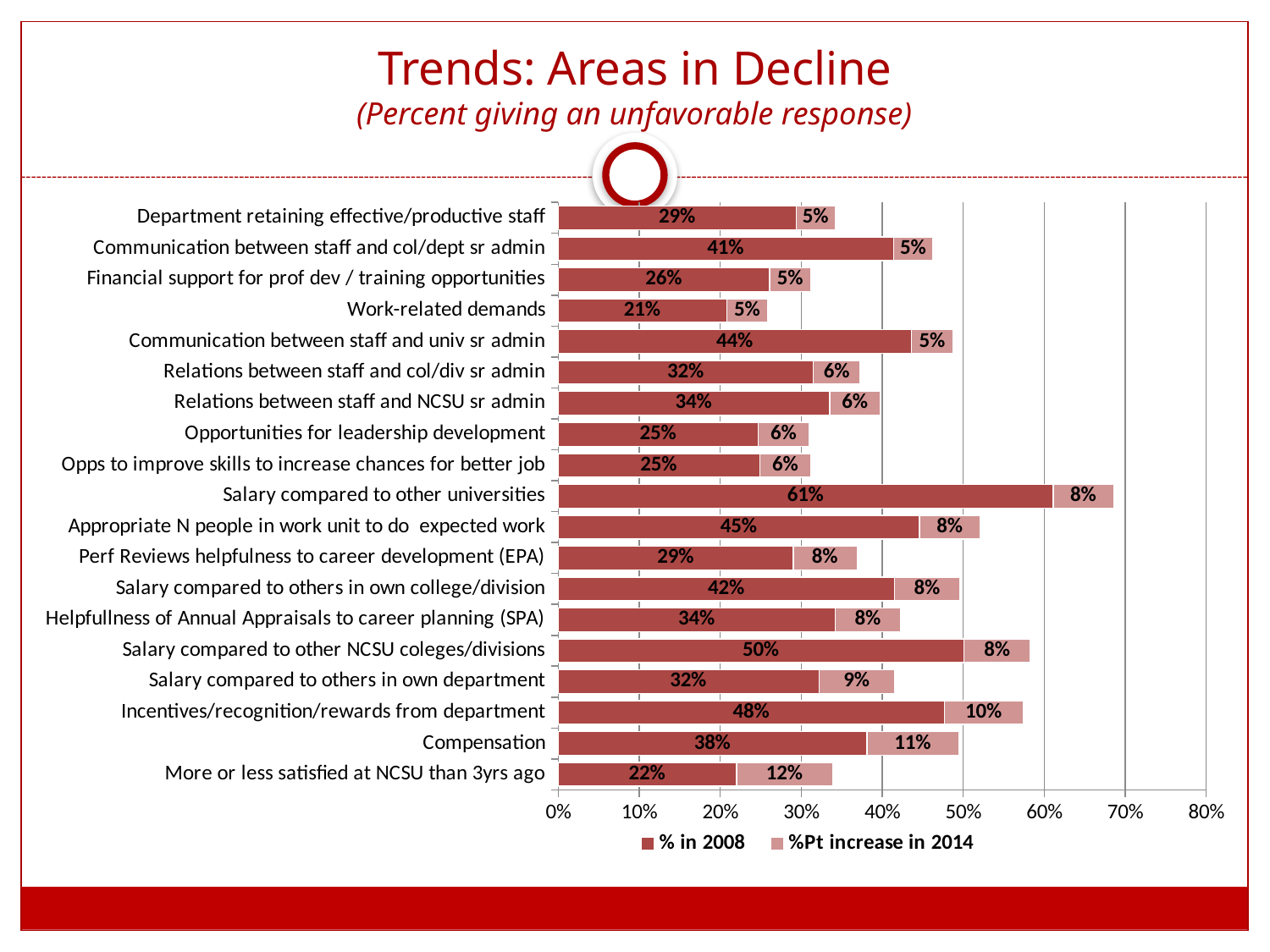
Which category has the largest %Pt increase in 2014? More or less satisfied at NCSU than 3yrs ago What is the difference in % in 2008 between Communication between staff and univ sr admin and Work-related demands? 23 percentage points Which category has the lowest % in 2008 value? Work-related demands What is the % in 2008 value for Salary compared to other universities? 61% What kind of chart is shown on the slide? Stacked bar chart What is the % in 2008 value for Work-related demands? 21% Which category has the highest % in 2008 value? Salary compared to other universities Which has a higher % in 2008 value: Incentives/recognition/rewards from department or Compensation? Incentives/recognition/rewards from department How many categories are shown in the chart? 19 What is the total length of the stacked bar for Salary compared to other universities (% in 2008 plus %Pt increase in 2014)? 69% How many series does the legend list? 2 What is the %Pt increase in 2014 for Compensation? 11%